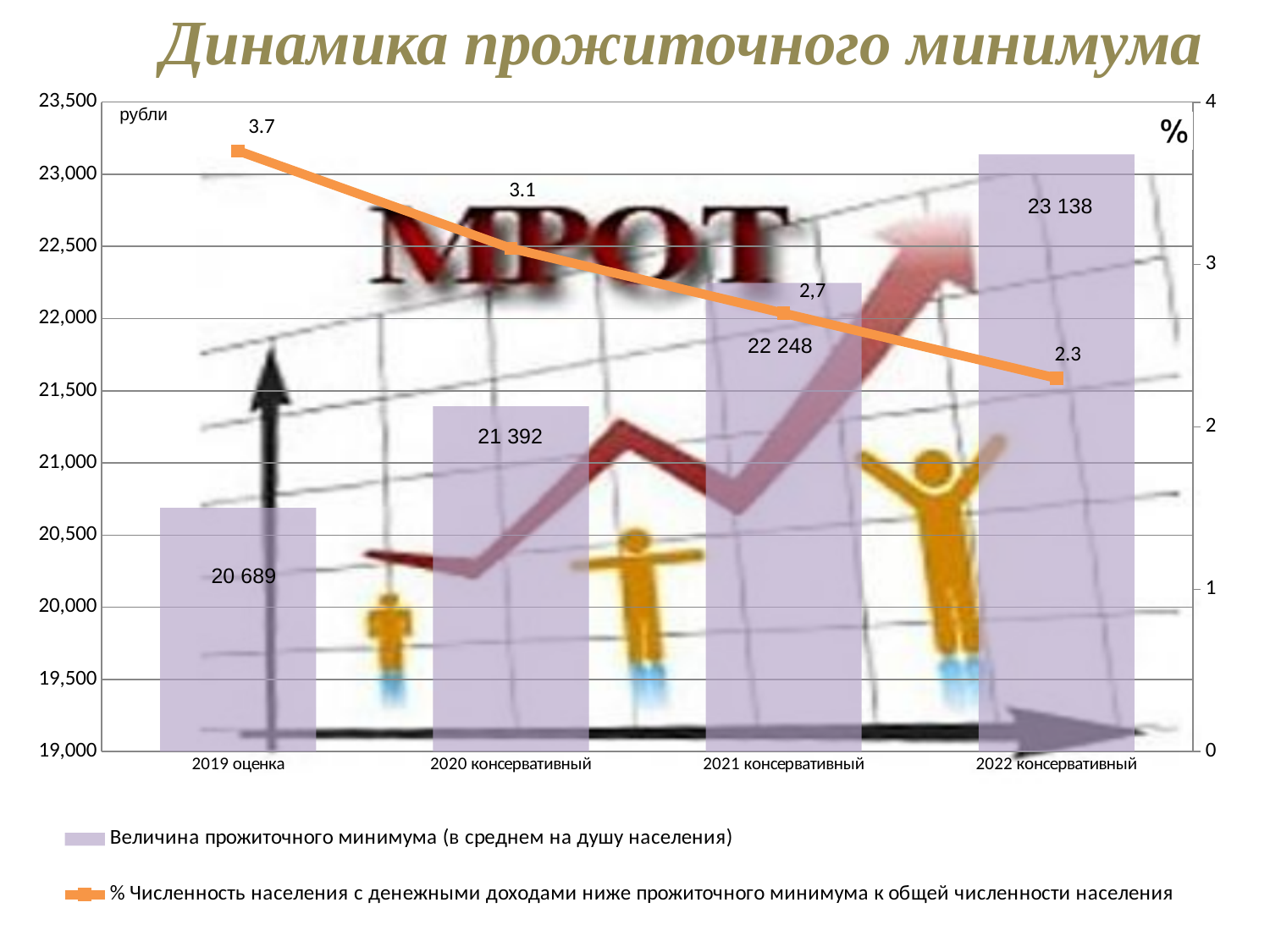
Which is larger: the subsistence minimum for 2020 консервативный or for 2021 консервативный? 2021 консервативный How many categories are shown on the x axis? 4 Which category has the lowest percentage of population with incomes below the subsistence minimum? 2022 консервативный What is the percentage of population with incomes below the subsistence minimum for 2020 консервативный? 3.1 How many series does the legend list? 2 What is the title of the chart? Динамика прожиточного минимума What is the percentage of population with incomes below the subsistence minimum for 2021 консервативный? 2,7 What is the value of the subsistence minimum for 2022 консервативный? 23 138 Which category has the highest subsistence minimum value? 2022 консервативный What is the difference between the subsistence minimum for 2022 консервативный and 2019 оценка? 2 449 What is the value of the subsistence minimum (Величина прожиточного минимума) for 2019 оценка? 20 689 Does the percentage of population with incomes below the subsistence minimum rise or fall from 2019 to 2022? fall